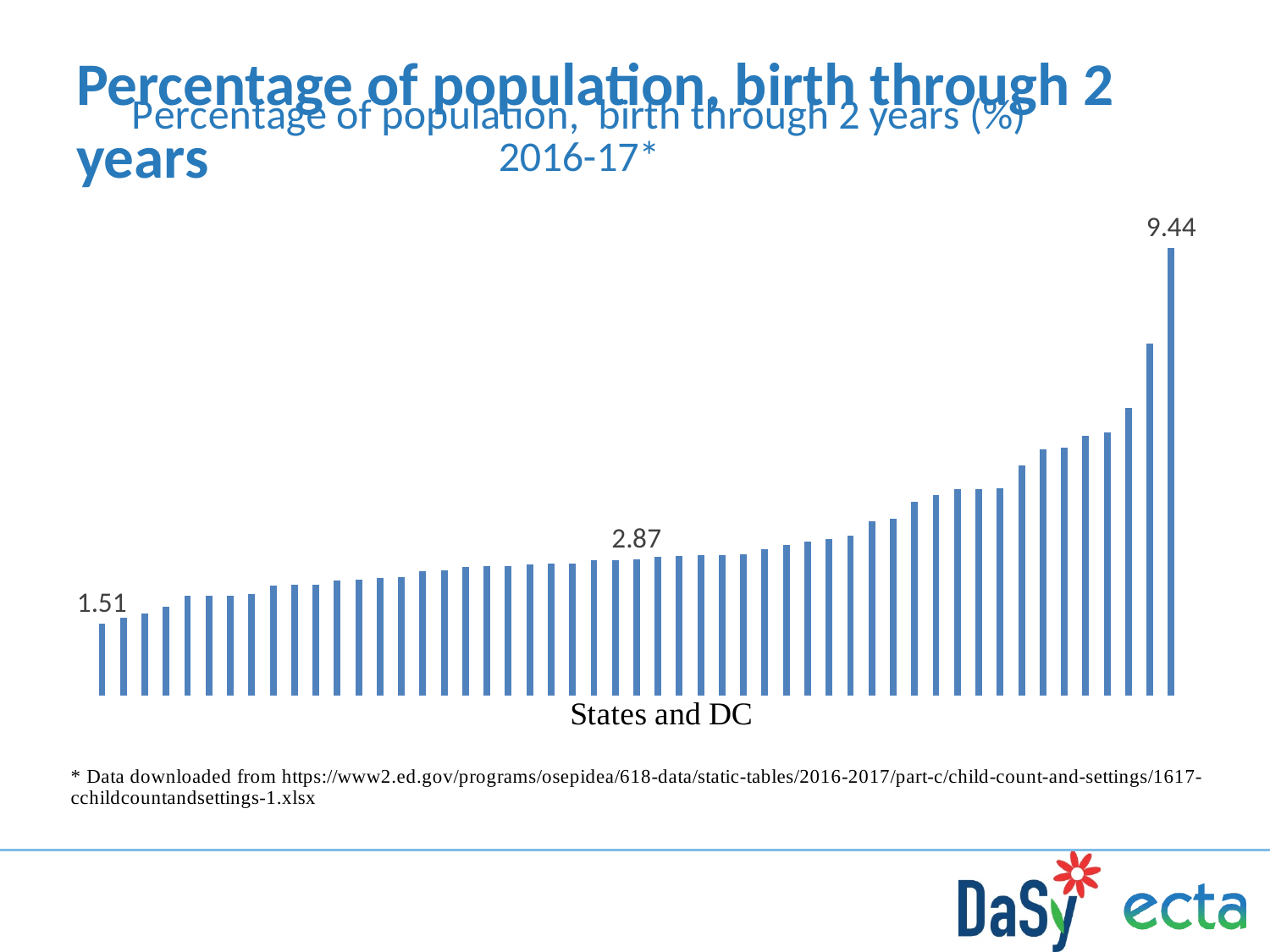
Which is larger, the value of the first bar on the left or the value of the last bar on the right? the last bar on the right What is the label on the horizontal axis of the chart? States and DC What time period does the chart title say the data covers? 2016-17 What is the value of the tallest bar in the chart? 9.44 What is the difference between the middle labeled value (2.87) and the lowest labeled value (1.51)? 1.36 What is the difference between the highest labeled value (9.44) and the lowest labeled value (1.51)? 7.93 What is the difference between the highest labeled value (9.44) and the middle labeled value (2.87)? 6.57 What value is labeled on the bar in the middle of the chart? 2.87 What kind of chart is shown on the slide? bar chart Do the bar values rise or fall moving from left to right across the chart? rise What is the value of the shortest bar in the chart? 1.51